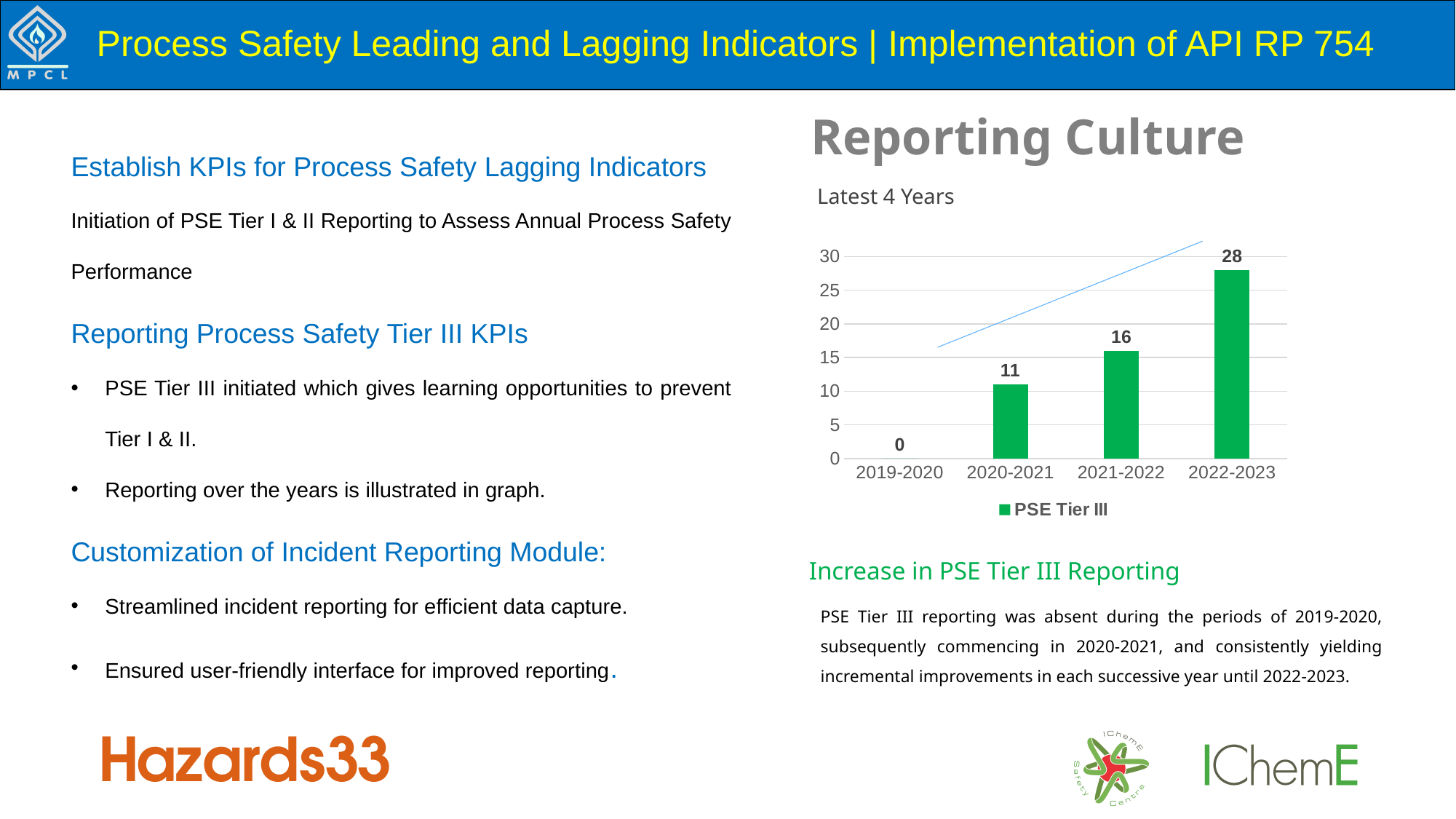
How many series does the chart legend list? 1 What is the difference between the PSE Tier III values for 2022-2023 and 2021-2022? 12 How many periods are shown on the x axis of the chart? 4 Do the PSE Tier III values rise or fall from 2019-2020 to 2022-2023? rise Is the PSE Tier III value for 2021-2022 greater or less than 20? less Which period has the lowest PSE Tier III value? 2019-2020 What is the PSE Tier III value for 2019-2020? 0 What is the PSE Tier III value for 2020-2021? 11 What is the PSE Tier III value for 2022-2023? 28 What kind of chart is shown on the slide? bar chart Which is larger, the PSE Tier III value for 2021-2022 or for 2020-2021? 2021-2022 Which period has the highest PSE Tier III value? 2022-2023